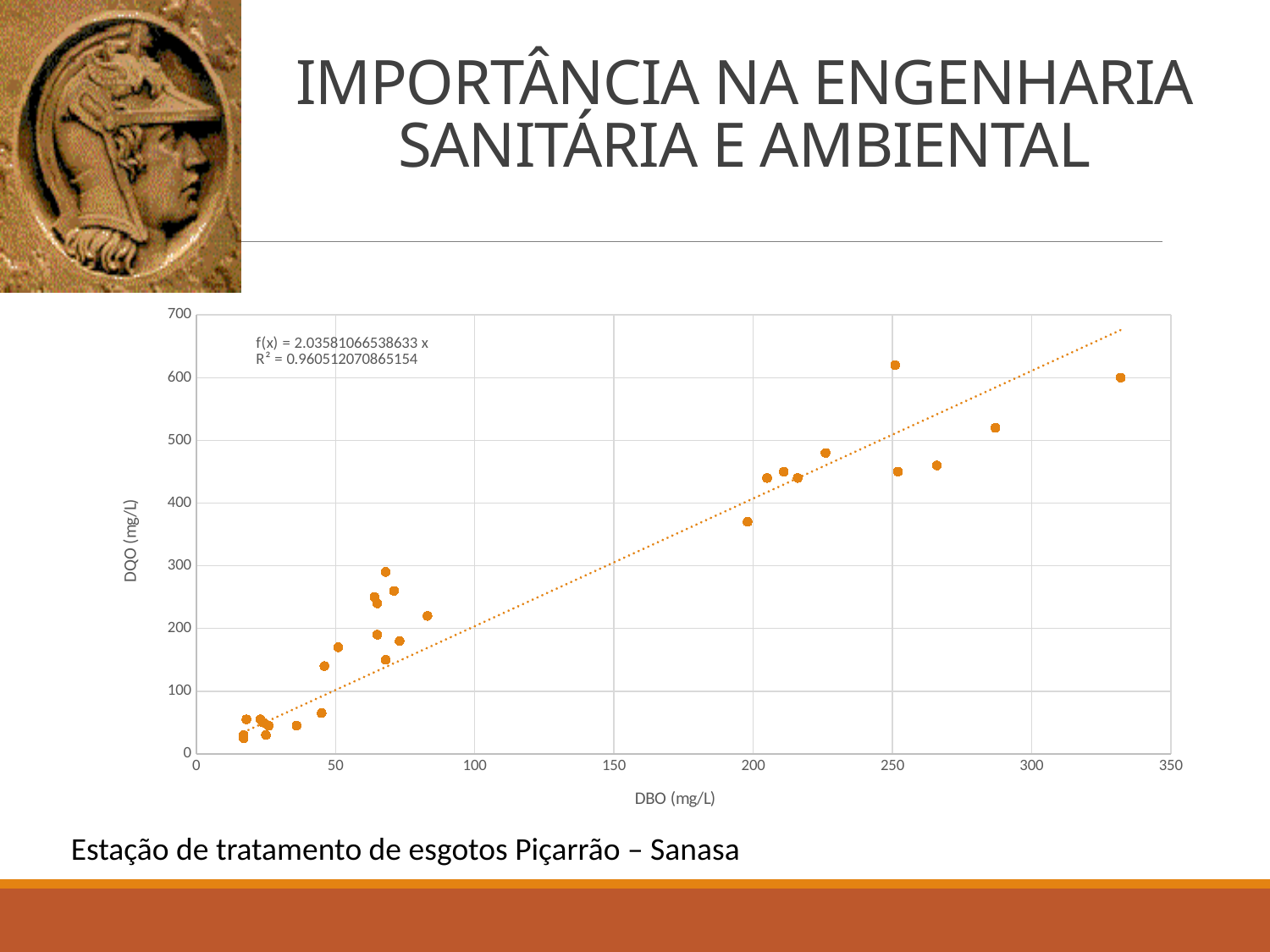
Is the DQO value for the point at a DBO of about 290 greater or less than 500? greater Is the highest DQO value plotted on the chart greater or less than 600? greater What R² value is printed on the chart? 0.960512070865154 Do the DQO values generally rise or fall as DBO increases along the x axis? rise What is the label of the x axis of the chart? DBO (mg/L) What trendline equation is printed on the chart? f(x) = 2.03581066538633 x What is the label of the y axis of the chart? DQO (mg/L) Is the DQO value for the point at a DBO of about 200 greater or less than 400? less What is the highest tick value shown on the y axis of the chart? 700 What is the highest tick value shown on the x axis of the chart? 350 What kind of chart is shown on the slide? scatter chart